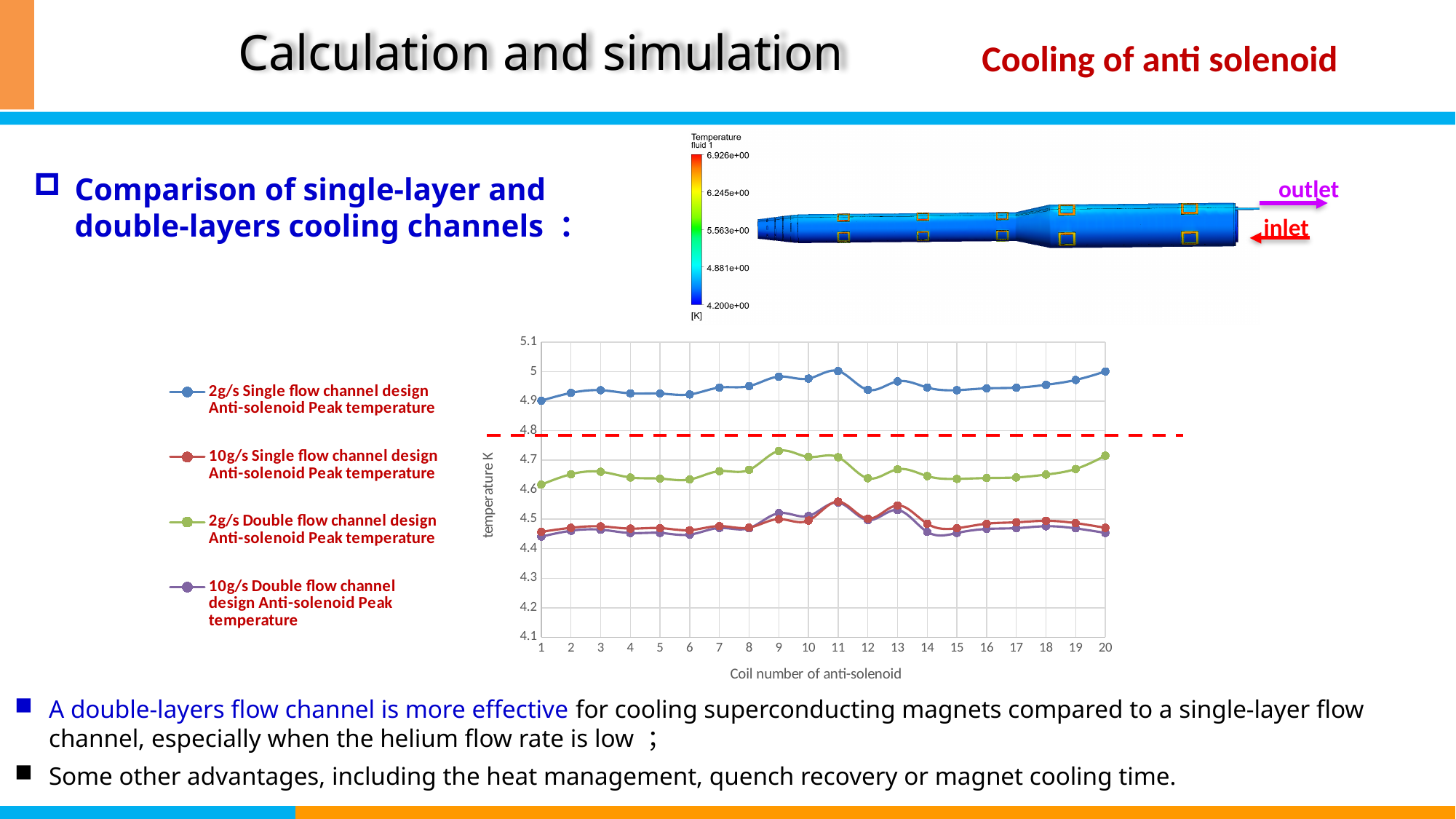
Is the value for the 10g/s Double flow channel design at coil 1 greater or less than 4.5? less How many coil numbers are plotted along the x axis of the chart? 20 What is the title of the y axis of the chart? temperature K How many series does the chart legend list? 4 What kind of chart is shown on the slide? line chart Is the value for the 2g/s Double flow channel design at coil 9 greater or less than 4.8? less Is the value for the 10g/s Single flow channel design at coil 11 greater or less than 4.5? greater Which series has the lowest peak temperatures across all coils? 10g/s Double flow channel design Anti-solenoid Peak temperature What is the title of the x axis of the chart? Coil number of anti-solenoid At coil 5, which is larger: the 2g/s Single flow channel design or the 2g/s Double flow channel design? 2g/s Single flow channel design Which series has the highest peak temperatures across all coils? 2g/s Single flow channel design Anti-solenoid Peak temperature